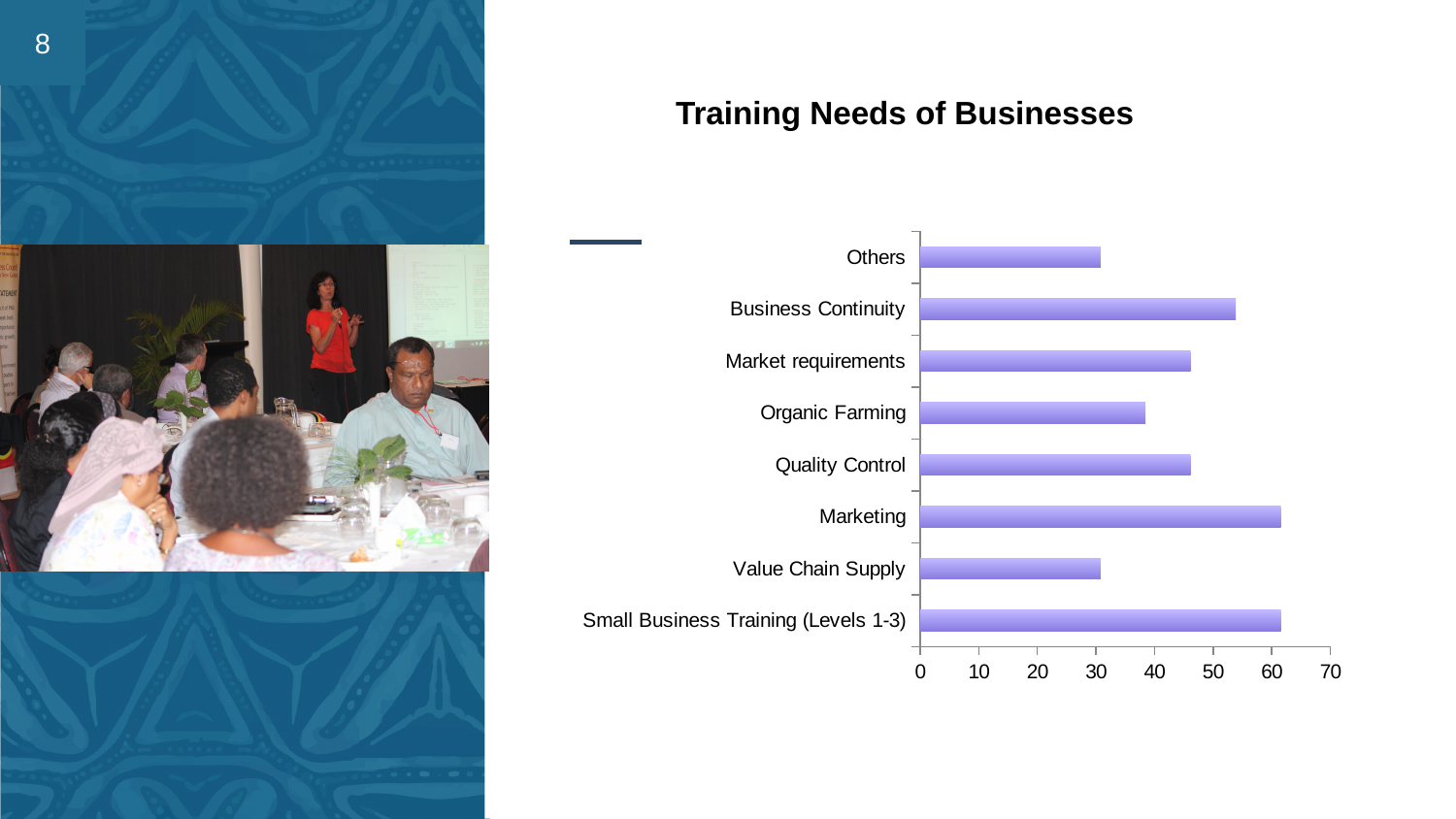
Is the value for Others greater or less than 40? less Is the value for Organic Farming greater or less than 40? less Is the value for Marketing greater or less than 60? greater Which has a larger value, Business Continuity or Organic Farming? Business Continuity Which has a larger value, Marketing or Quality Control? Marketing Which has a larger value, Market requirements or Value Chain Supply? Market requirements What is the title of the chart? Training Needs of Businesses What kind of chart is shown on the slide? bar chart How many categories are plotted in the chart? 8